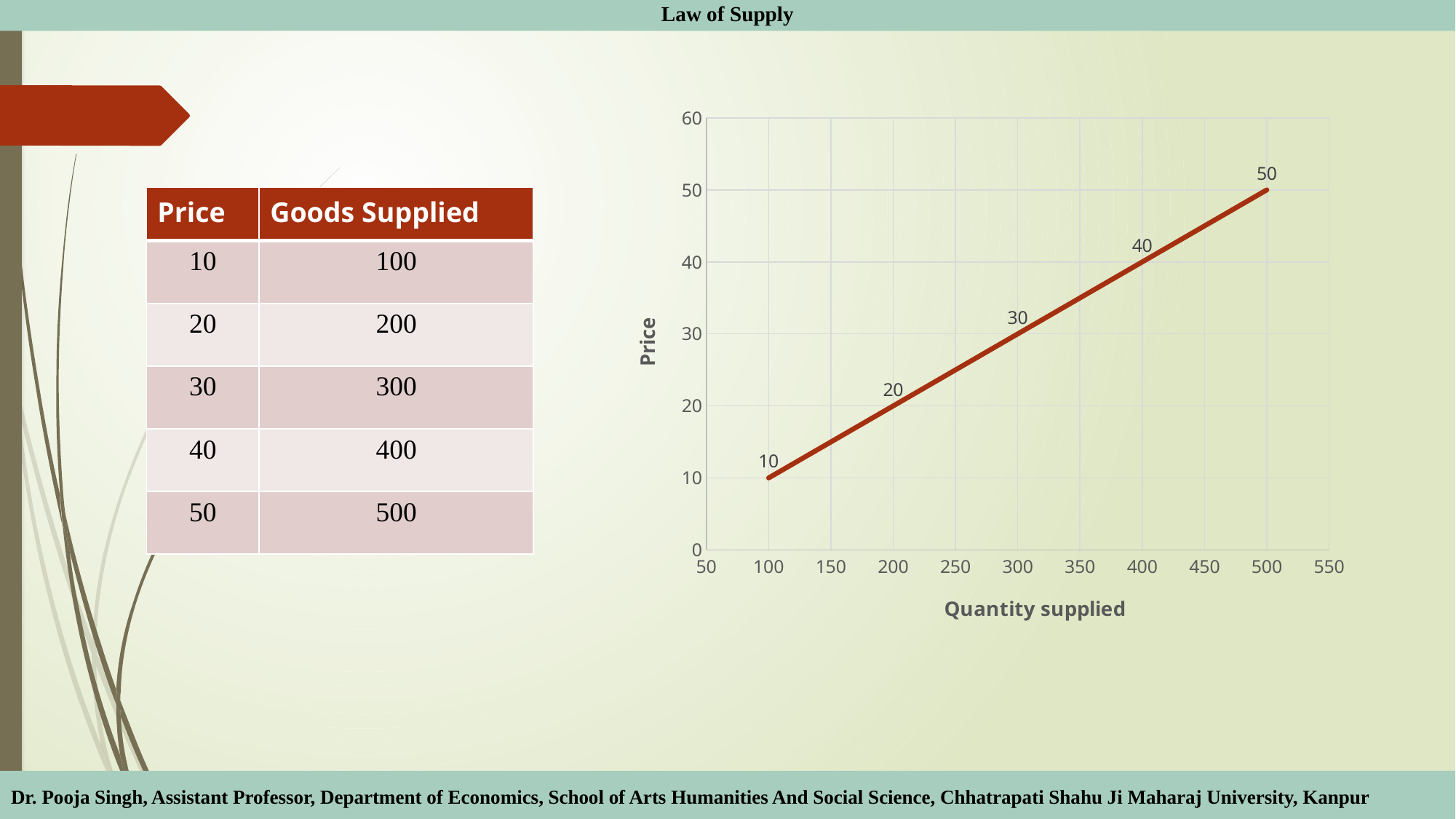
Does the price rise or fall as quantity supplied increases along the x axis? Rises Is the price at a quantity supplied of 400 greater or less than 30? greater What type of chart is shown on the slide? Line chart At which quantity supplied is the price lowest? 100 What is the title of the horizontal axis? Quantity supplied What is the price data label at a quantity supplied of 300? 30 What is the difference between the price at quantity 500 and the price at quantity 100? 40 What is the price data label at a quantity supplied of 100? 10 At which quantity supplied is the price highest? 500 How many data points are plotted on the line? 5 What is the price data label at a quantity supplied of 500? 50 Which is larger, the price at quantity 400 or the price at quantity 200? Price at quantity 400